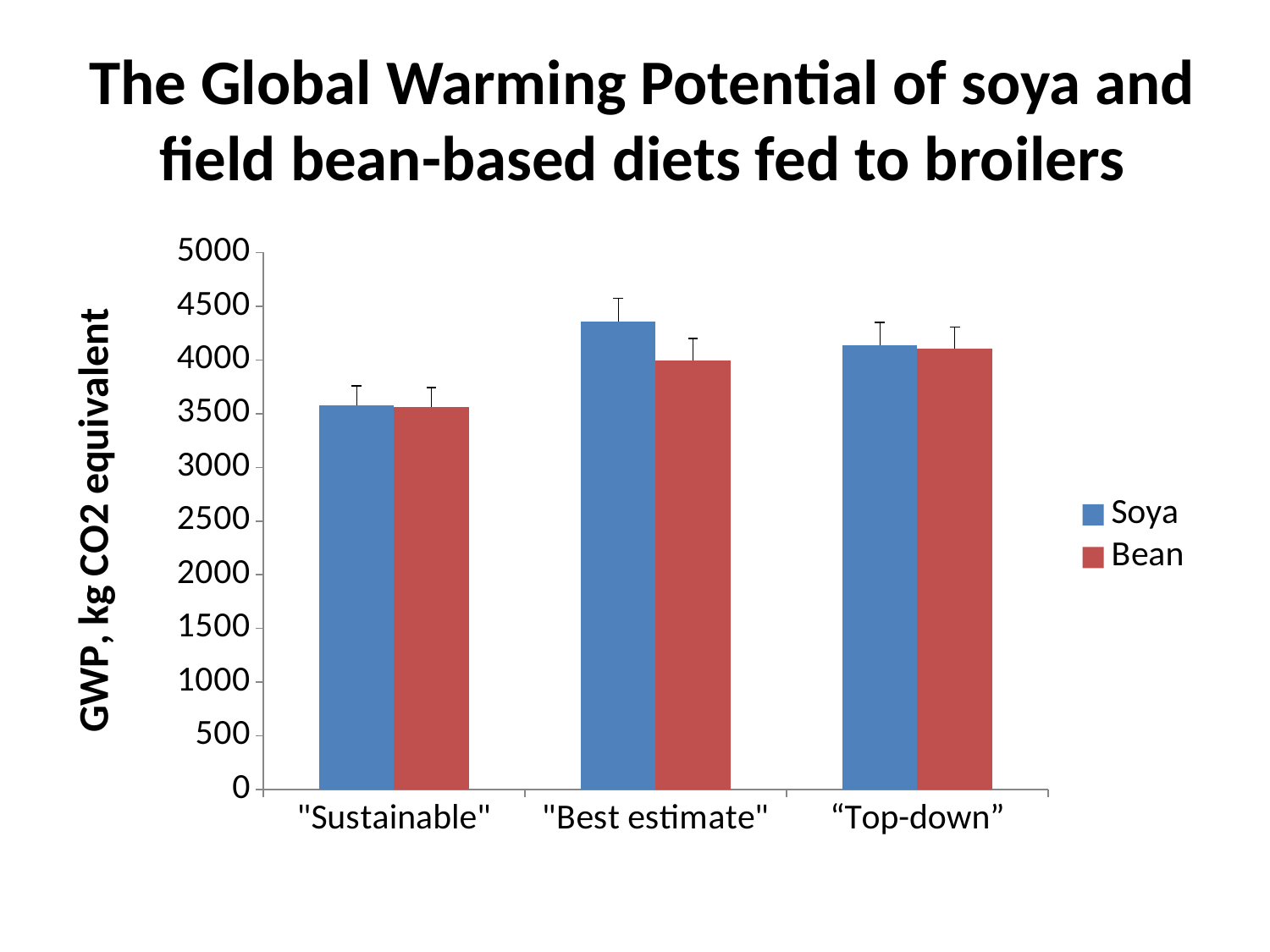
Is the Bean value for "Sustainable" greater or less than 4000? less Is the Soya value for "Sustainable" greater or less than 3000? greater Which category has the highest Soya value? "Best estimate" Which category has the lowest Bean value? "Sustainable" What kind of chart is shown on the slide? bar chart In the "Best estimate" category, which is larger, the Soya value or the Bean value? Soya How many series does the chart's legend list? 2 Which series are listed in the chart's legend? Soya and Bean How many categories are shown on the x axis of the chart? 3 Which category has the lowest Soya value? "Sustainable" Is the Soya value for "Best estimate" greater or less than 4000? greater What is the label of the vertical axis of the chart? GWP, kg CO2 equivalent